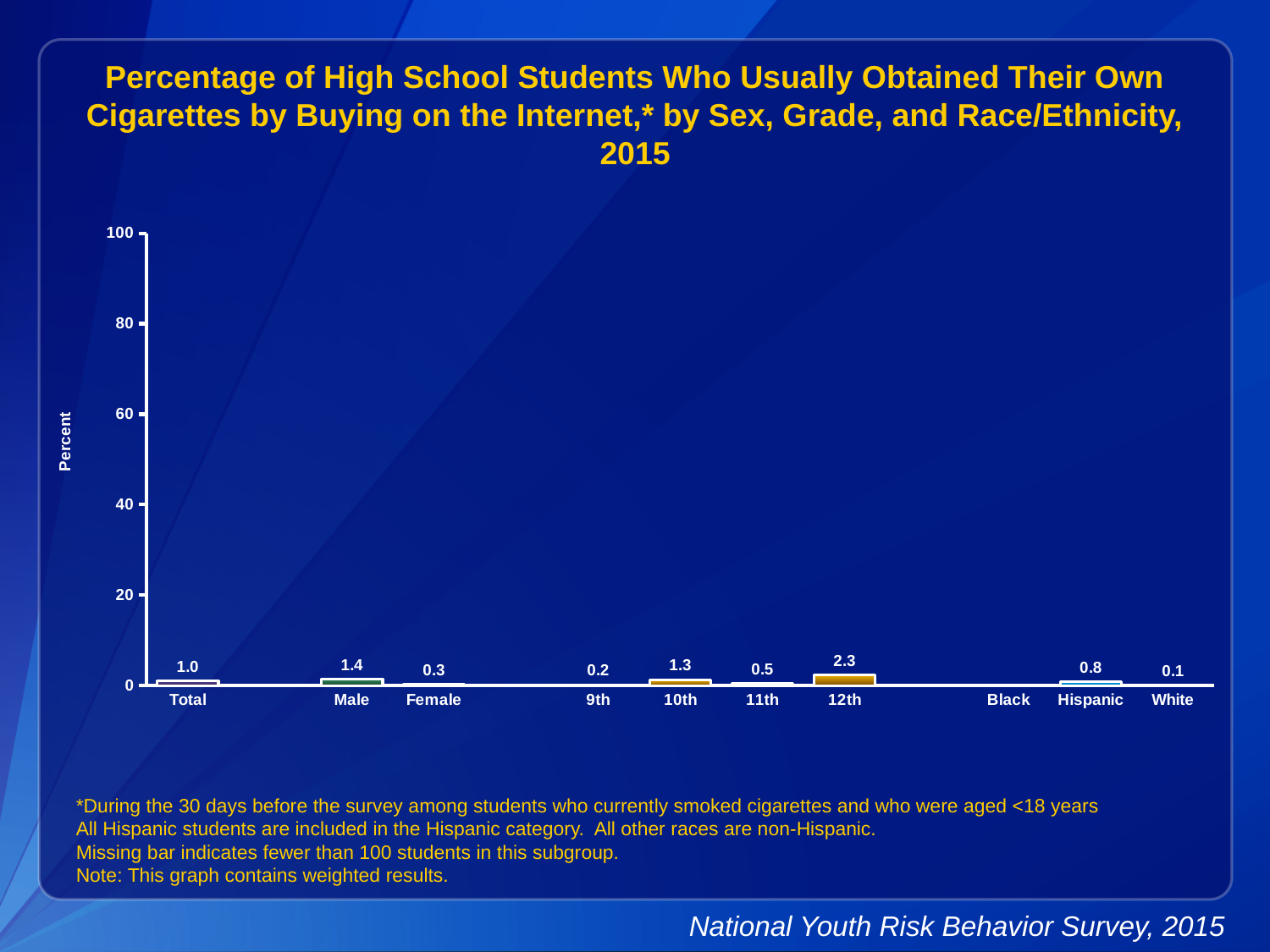
What is the value for Male? 1.4 What kind of chart is shown on the slide? bar chart Which is larger, the value for 10th grade or 11th grade? 10th Which grade has the lowest value? 9th Which category has no bar shown? Black Is the value for 12th grade greater or less than 20? less What is the value for Hispanic students? 0.8 What is the difference between the Male and Female values? 1.1 What is the value for 12th grade? 2.3 Which category has the highest value? 12th How many categories are labeled on the x axis? 10 What is the value for Total? 1.0